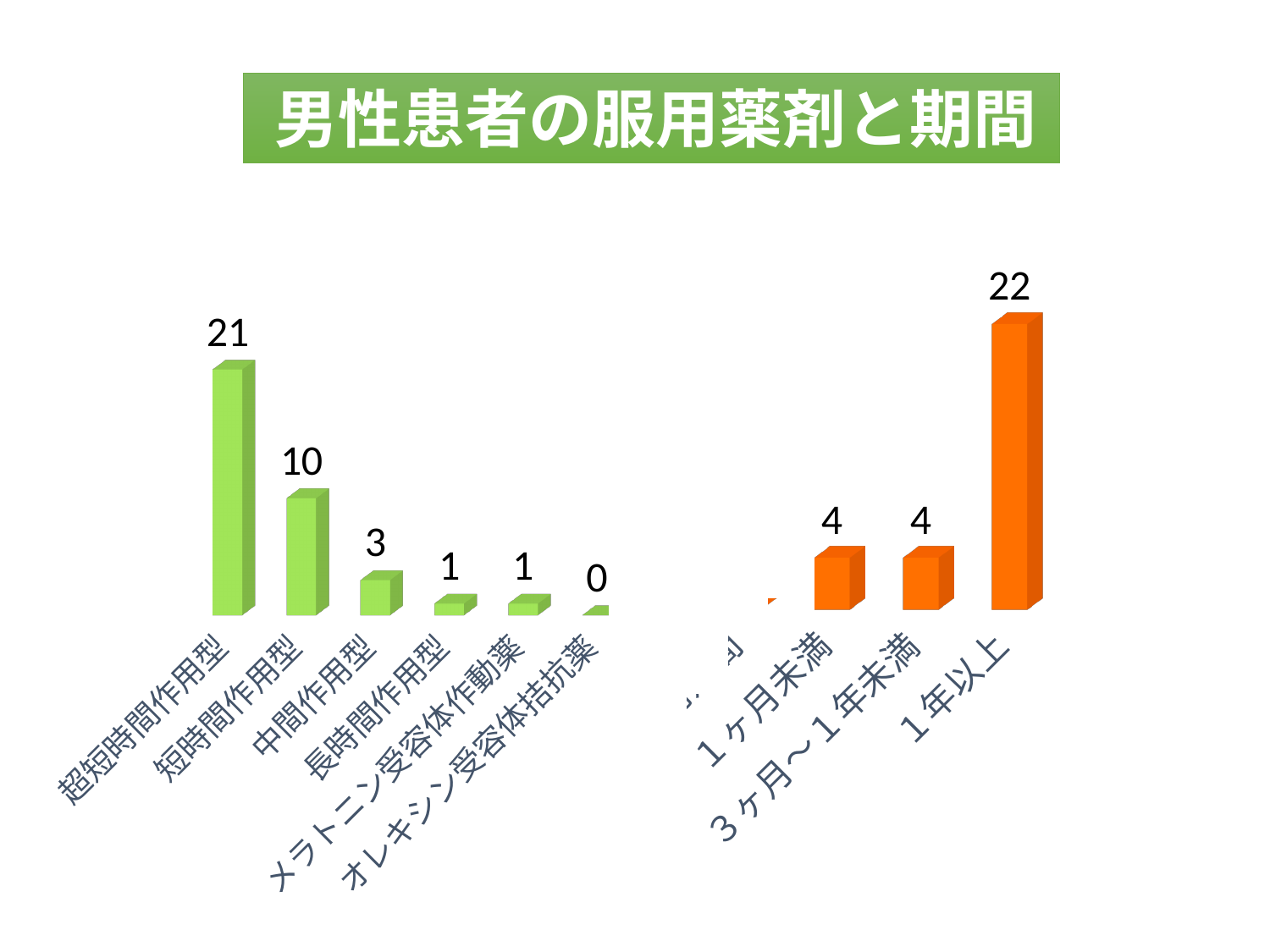
In the left chart, what is the value for 中間作用型? 3 In the left chart, how many categories are shown? 6 In the left chart, what is the value for オレキシン受容体拮抗薬? 0 In the left chart, what is the value for 短時間作用型? 10 In the right chart, what is the value for 1年以上? 22 In the left chart, which category has the highest value? 超短時間作用型 In the left chart, what is the value for 超短時間作用型? 21 In the right chart, which is larger, the value for 1年以上 or the value for 1ヶ月未満? 1年以上 In the left chart, what is the difference between the values for 超短時間作用型 and 短時間作用型? 11 In the right chart, what is the value for 3ヶ月～1年未満? 4 What is the title of the slide? 男性患者の服用薬剤と期間 In the left chart, which category has the lowest value? オレキシン受容体拮抗薬